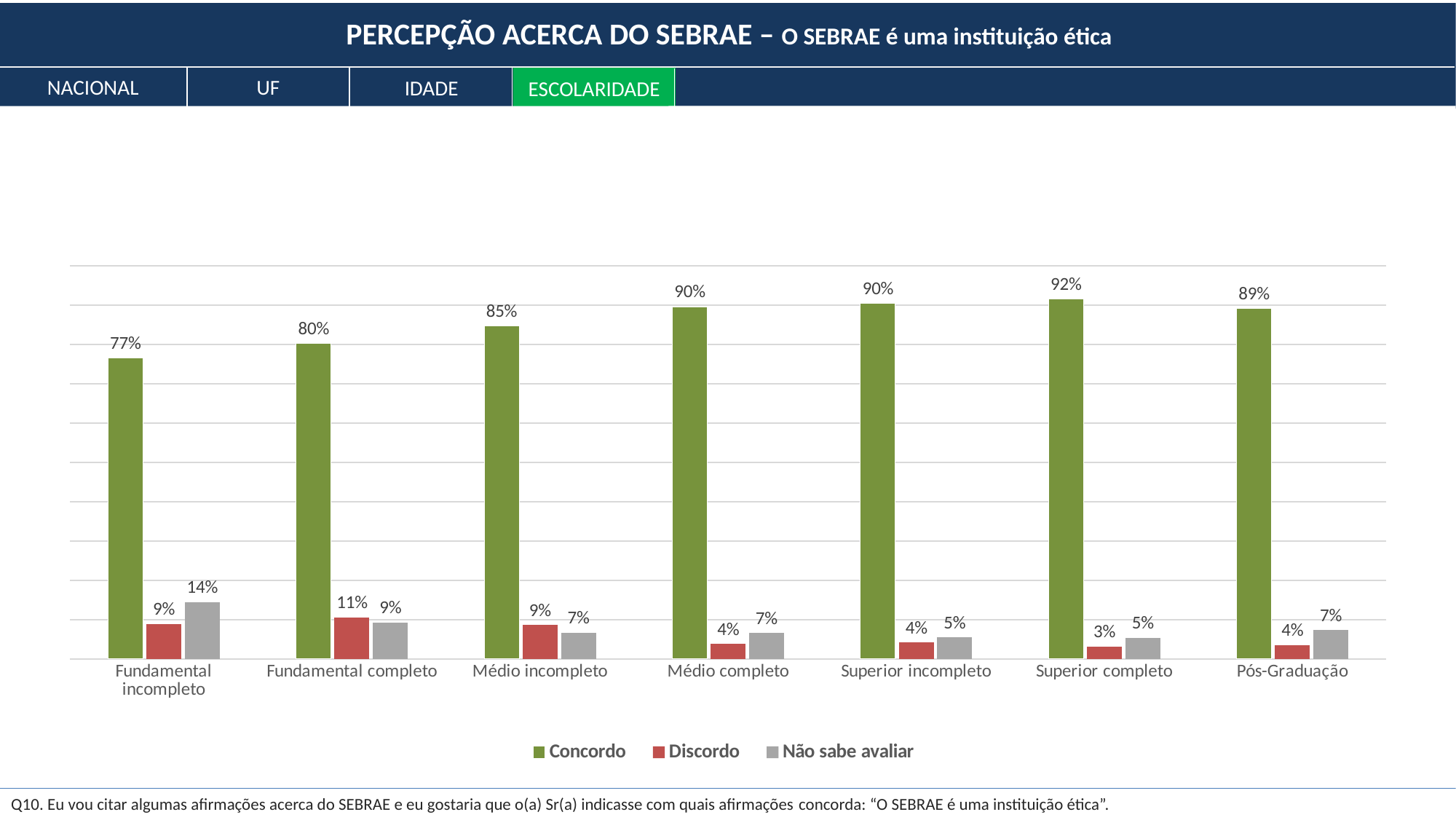
Which category has the highest Concordo value? Superior completo How many series does the legend list? 3 What is the Discordo value for Fundamental completo? 11% What is the Não sabe avaliar value for Pós-Graduação? 7% How many education categories are shown on the x axis? 7 What is the Concordo value for Superior completo? 92% What is the Não sabe avaliar value for Fundamental incompleto? 14% What kind of chart is shown on the slide? Bar chart What is the difference between the Concordo values for Superior completo and Fundamental incompleto? 15% Which category has the lowest Concordo value? Fundamental incompleto Which series is shown in green in the legend? Concordo Which is larger, the Discordo value for Médio incompleto or for Médio completo? Médio incompleto